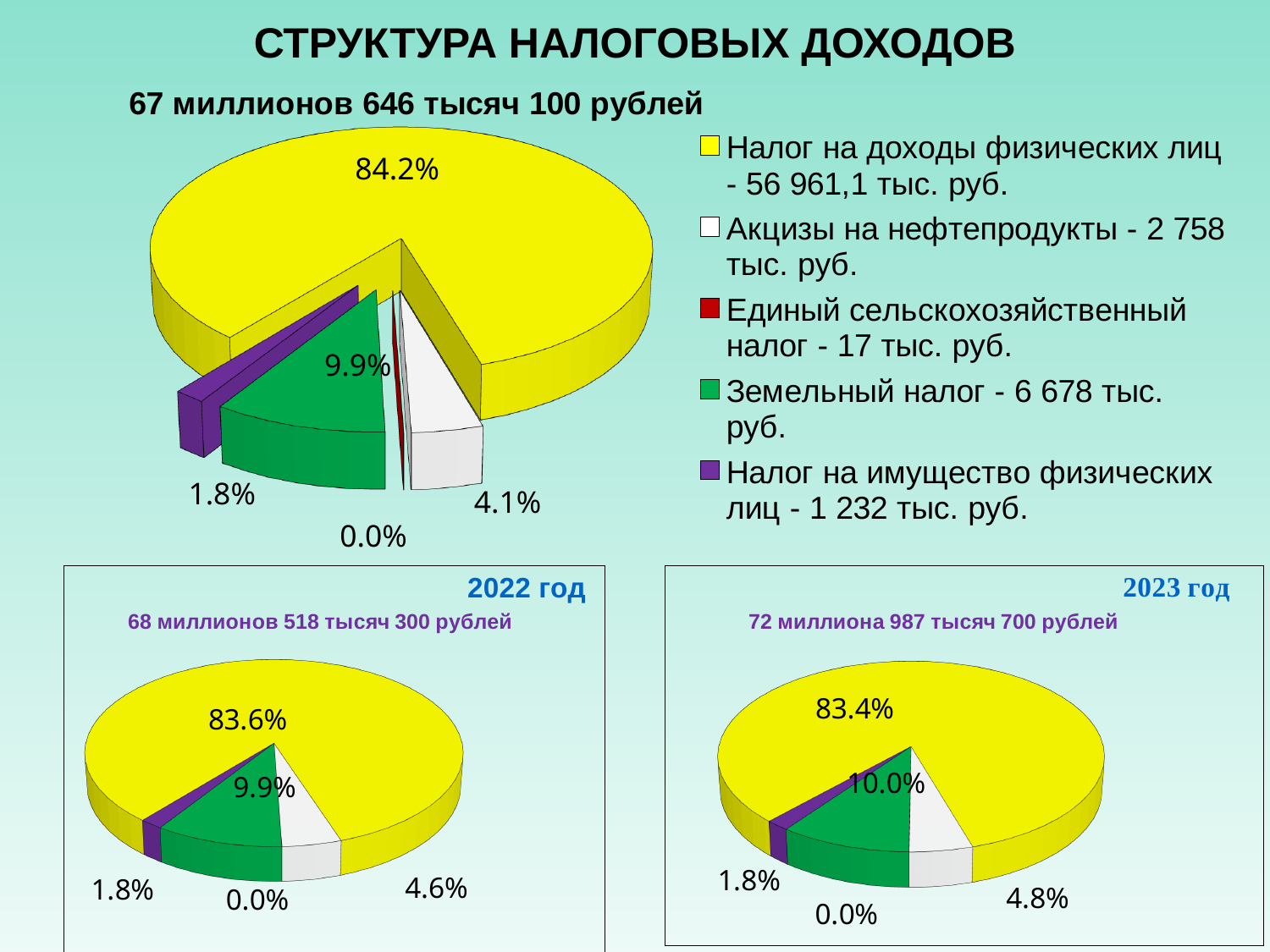
What kind of chart is used on this slide? Pie chart On the 2023 год chart, what share is shown for the green slice? 10.0% On the top pie chart, what share is shown for Земельный налог (the green slice)? 9.9% On the top pie chart, what is the difference in percentage points between the yellow slice (84.2%) and the green slice (9.9%)? 74.3 percentage points On the top pie chart, which category has the largest slice? Налог на доходы физических лиц On the 2022 год chart, what share is shown for the largest (yellow) slice? 83.6% What total amount is printed above the top pie chart? 67 миллионов 646 тысяч 100 рублей How many categories does the legend of the top pie chart list? 5 On the top pie chart, which category has the smallest slice? Единый сельскохозяйственный налог On the top pie chart, what share is shown for Налог на доходы физических лиц (the yellow slice)? 84.2% Which chart shows a larger share for the white slice: 2022 год (4.6%) or 2023 год (4.8%)? 2023 год According to the legend of the top pie chart, what is the amount for Акцизы на нефтепродукты? 2 758 тыс. руб.